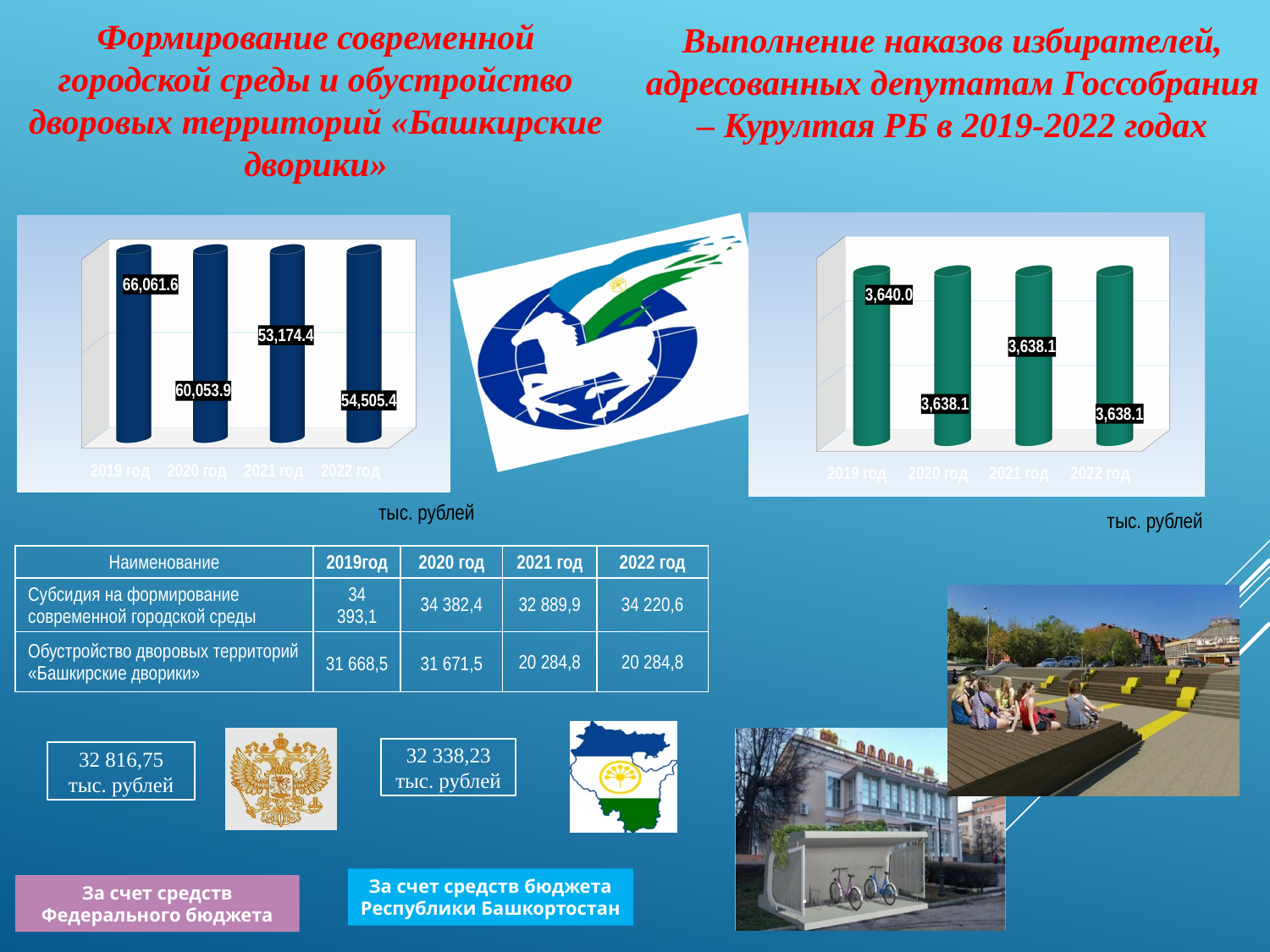
On the left chart, which year has the highest value? 2019 год What kind of chart is the right chart? Bar chart On the left chart, which year has the lowest value? 2021 год On the left chart, what is the value for 2021 год? 53,174.4 On the right chart, what is the value for 2019 год? 3,640.0 On the right chart, what is the value for 2022 год? 3,638.1 On the left chart, which is larger, the value for 2021 год or 2022 год? 2022 год On the right chart, what is the difference between the values for 2019 год and 2020 год? 1.9 On the left chart, what is the difference between the values for 2019 год and 2020 год? 6,007.7 On the left chart, how many years are plotted? 4 On the left chart, what is the value for 2019 год? 66,061.6 What unit is stated below the left chart? тыс. рублей